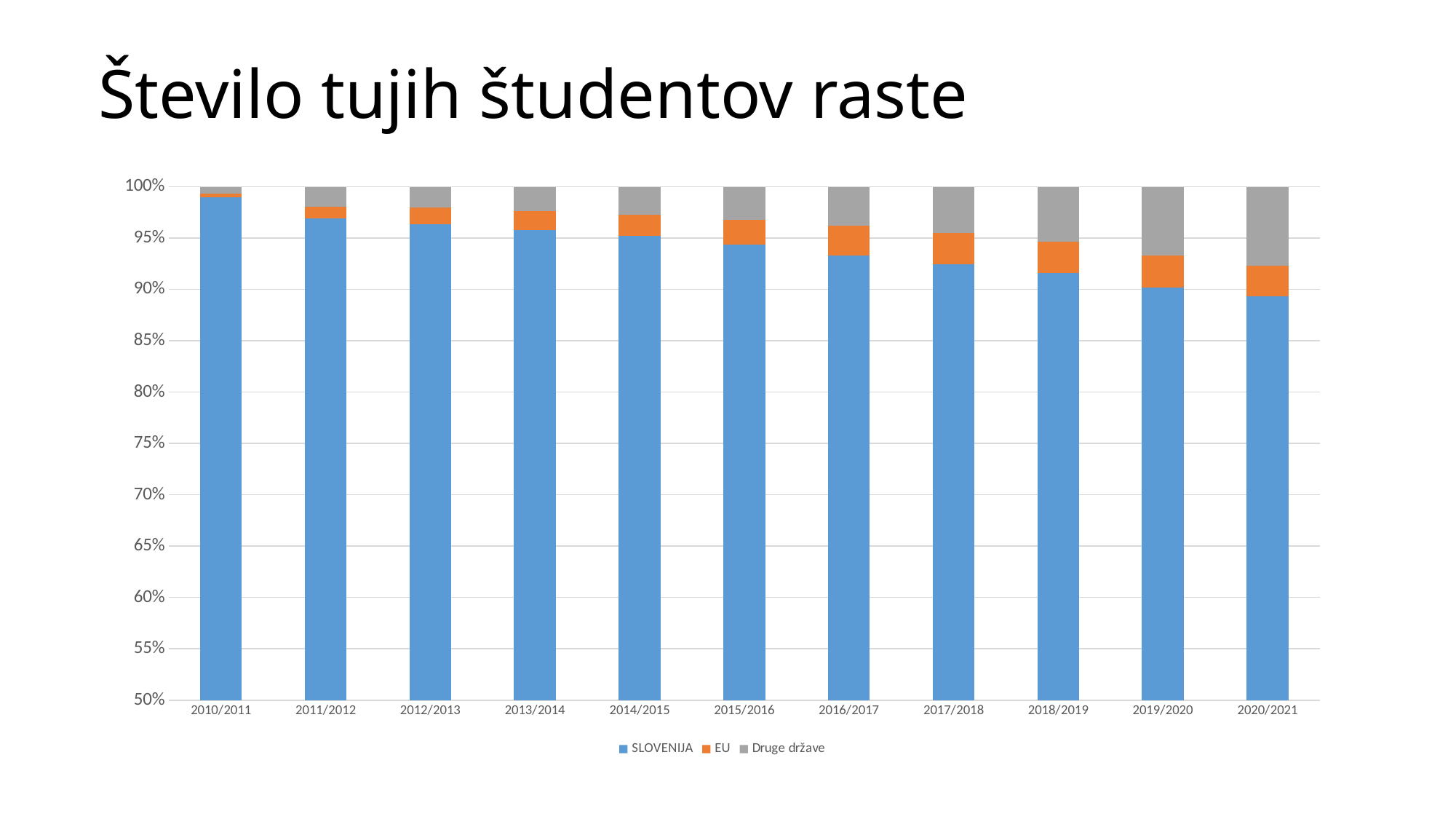
Which year has a larger Druge države share, 2011/2012 or 2019/2020? 2019/2020 In which academic year is the SLOVENIJA share the highest? 2010/2011 In which academic year is the Druge države share the largest? 2020/2021 How many series does the legend list? 3 How many academic years are shown on the x axis? 11 In which academic year is the SLOVENIJA share the lowest? 2020/2021 Is the SLOVENIJA share for 2012/2013 greater or less than 95%? greater What are the three series listed in the legend? SLOVENIJA, EU, Druge države Is the SLOVENIJA share for 2020/2021 greater or less than 90%? less What kind of chart is shown on the slide? Stacked bar chart What is the title of the slide? Število tujih študentov raste Does the share for SLOVENIJA rise or fall from 2010/2011 to 2020/2021? Fall